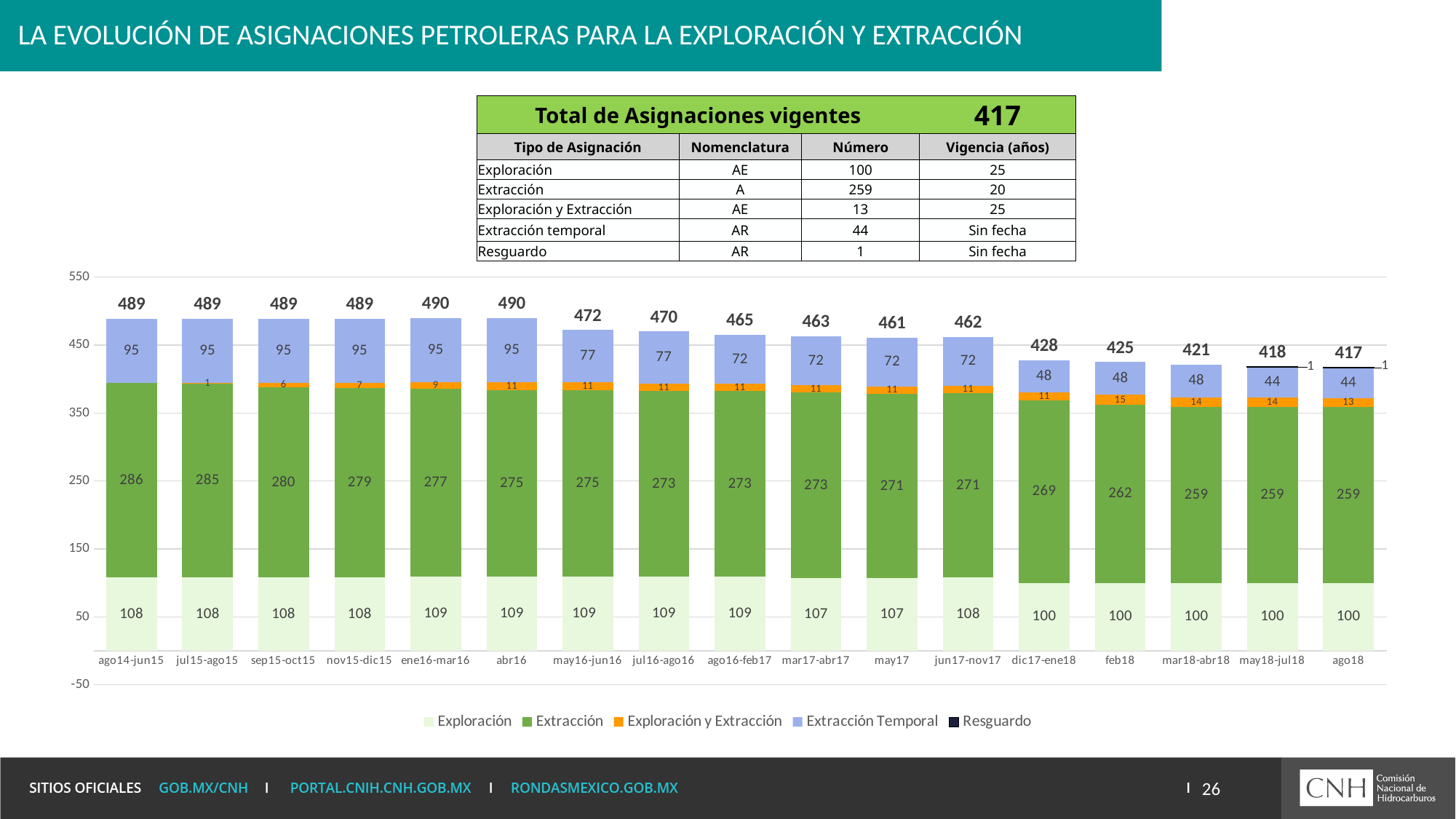
What is the Extracción Temporal value for the ago18 bar? 44 Which series is shown in orange in the legend? Exploración y Extracción How many series does the chart legend list? 5 Do the bar totals generally rise or fall from ago14-jun15 to ago18? Fall What is the total of the stacked bar for ago18? 417 What is the difference between the total for ago14-jun15 and the total for ago18? 72 Which has the larger Extracción value, feb18 or mar18-abr18? feb18 How many periods (bars) are plotted along the x axis? 17 What is the Exploración y Extracción value for the feb18 bar? 15 What is the Extracción value for the ago14-jun15 bar? 286 Which period has the lowest total of assignments? ago18 What kind of chart is shown on the slide? Stacked bar chart